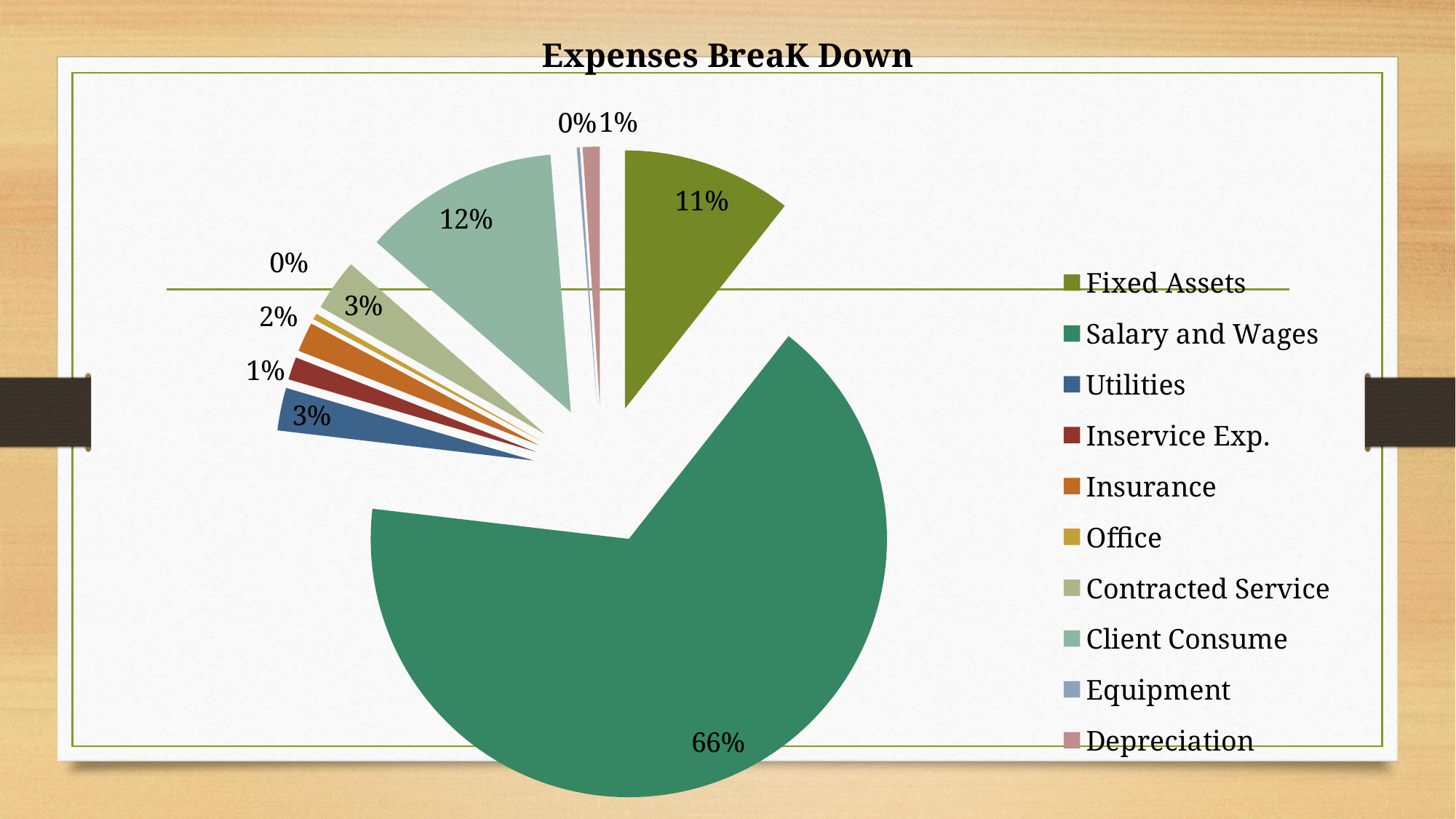
What percentage is shown for Insurance? 2% How many categories are listed in the legend? 10 What is the title of the chart? Expenses BreaK Down What share of the pie does Salary and Wages represent? 66% What percentage is shown for Utilities? 3% Which category has the largest share of the pie? Salary and Wages What percentage is shown for Client Consume? 12% Which legend entry is shown in the last position at the bottom of the legend? Depreciation What is the difference in percentage points between Salary and Wages and Client Consume? 54% Which is larger, the share for Client Consume or the share for Fixed Assets? Client Consume What percentage is shown for Fixed Assets? 11% What kind of chart is shown on the slide? Pie chart